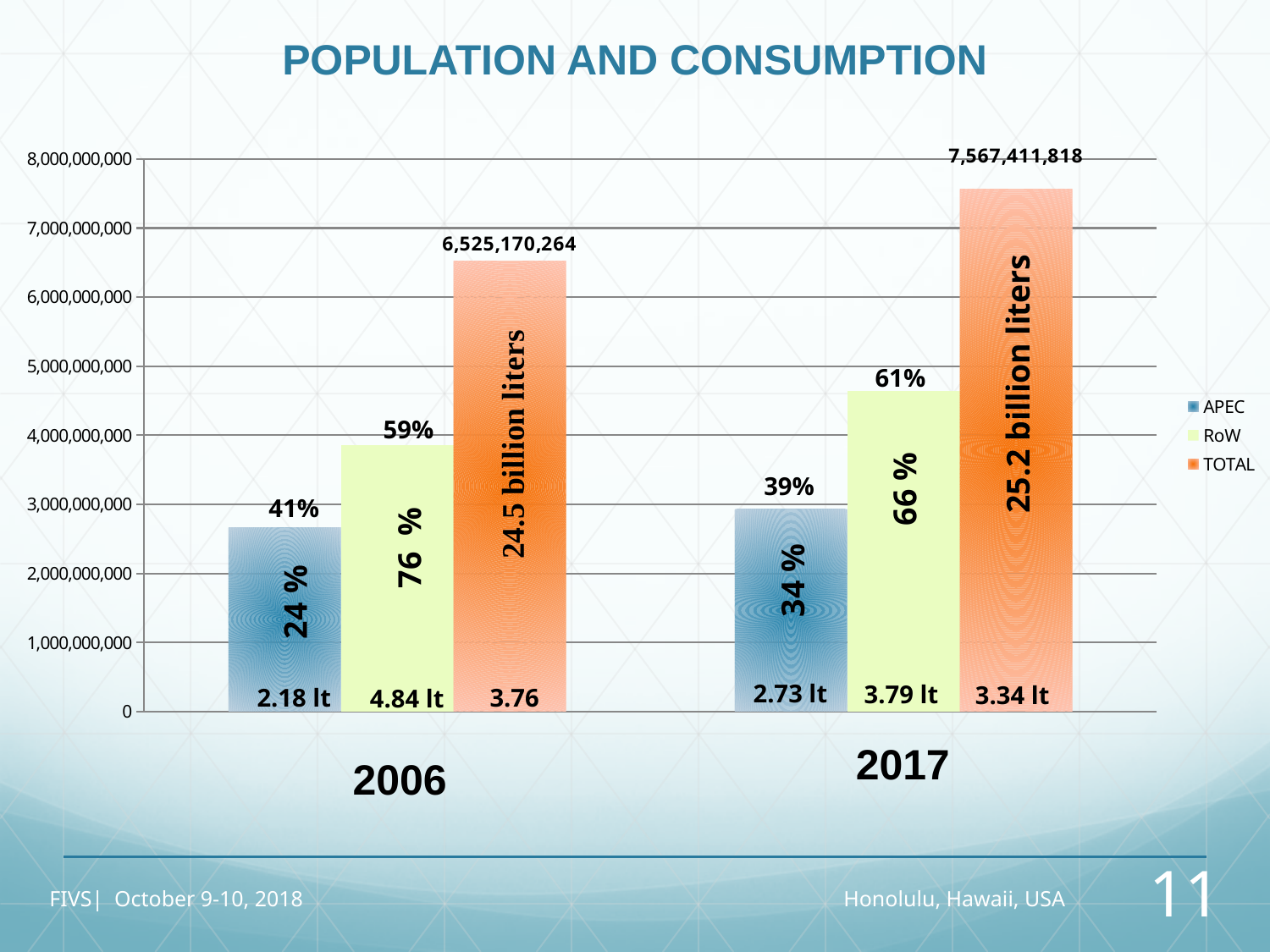
What is the title of the chart? POPULATION AND CONSUMPTION What is the difference between the TOTAL value for 2017 and the TOTAL value for 2006? 1,042,241,554 How many series does the legend list? 3 Which bar is the tallest in the chart? TOTAL for 2017 Which bar is the shortest in the chart? APEC for 2006 What is the TOTAL value labelled for 2017? 7,567,411,818 What kind of chart is shown on the slide? bar chart Does the TOTAL value rise or fall from 2006 to 2017? rise Is the APEC value for 2006 greater or less than 3,000,000,000? less Is the RoW value for 2017 greater or less than 4,000,000,000? greater How many year categories are shown on the x axis? 2 What is the TOTAL value labelled for 2006? 6,525,170,264